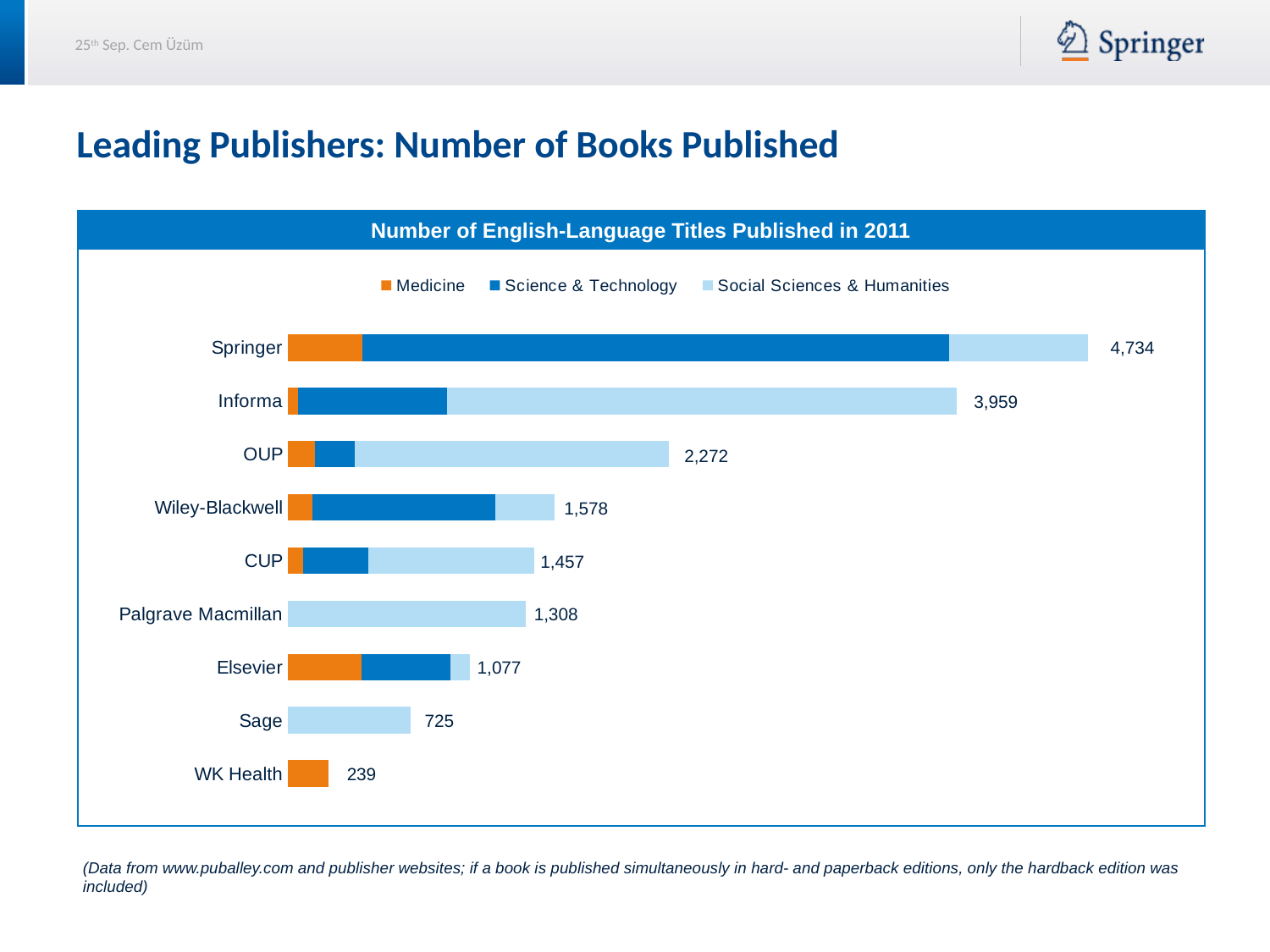
What is the total number of titles shown for Informa? 3,959 What type of chart is shown on the slide? Stacked bar chart Which publisher has a larger total, OUP or Elsevier? OUP What is the difference between the total titles for Wiley-Blackwell and CUP? 121 What is the total number of titles shown for Palgrave Macmillan? 1,308 How many series does the legend list? 3 What is the difference between the total titles for Springer and Informa? 775 What is the total number of titles shown for WK Health? 239 Which publisher has the lowest total number of titles published? WK Health How many publishers are shown in the chart? 9 What is the total number of English-language titles published in 2011 by Springer? 4,734 Which publisher has the highest total number of titles published? Springer